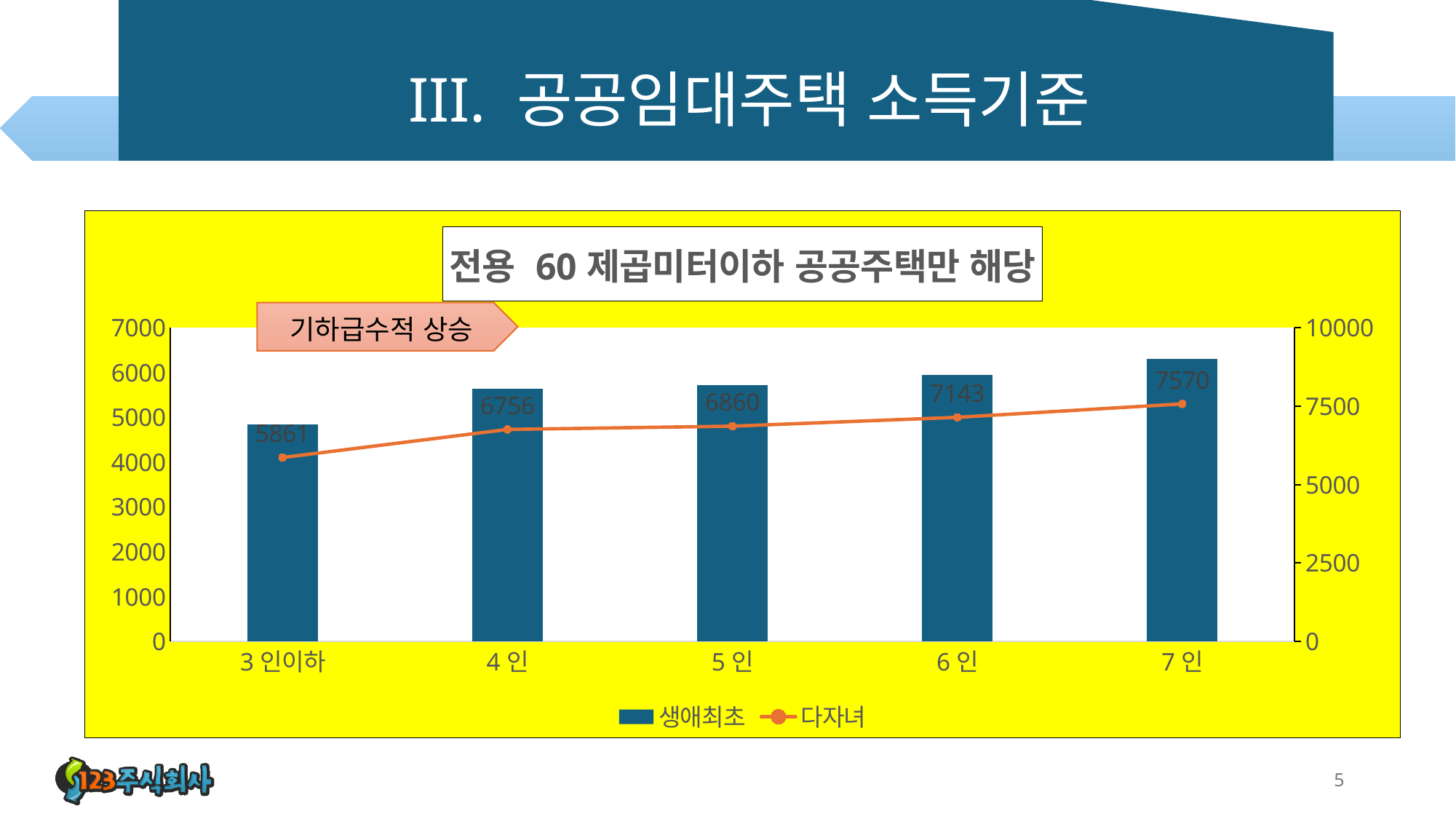
What is the difference between the 다자녀 values for 7 인 and 3 인이하? 1709 Which household size has the highest 다자녀 value? 7 인 Which household size has the lowest 다자녀 value? 3 인이하 Do the 다자녀 values rise or fall as household size increases along the x axis? rise How many household-size categories are shown on the x axis? 5 Is the 생애최초 bar for 3 인이하 greater or less than 5000 on the left axis? less What is the 다자녀 value for 7 인? 7570 What is the 다자녀 value for 3 인이하? 5861 Which is larger, the 다자녀 value for 4 인 or for 6 인? 6 인 Is the 생애최초 bar for 7 인 greater or less than 6000 on the left axis? greater What is the 다자녀 value for 5 인? 6860 How many series does the legend list? 2